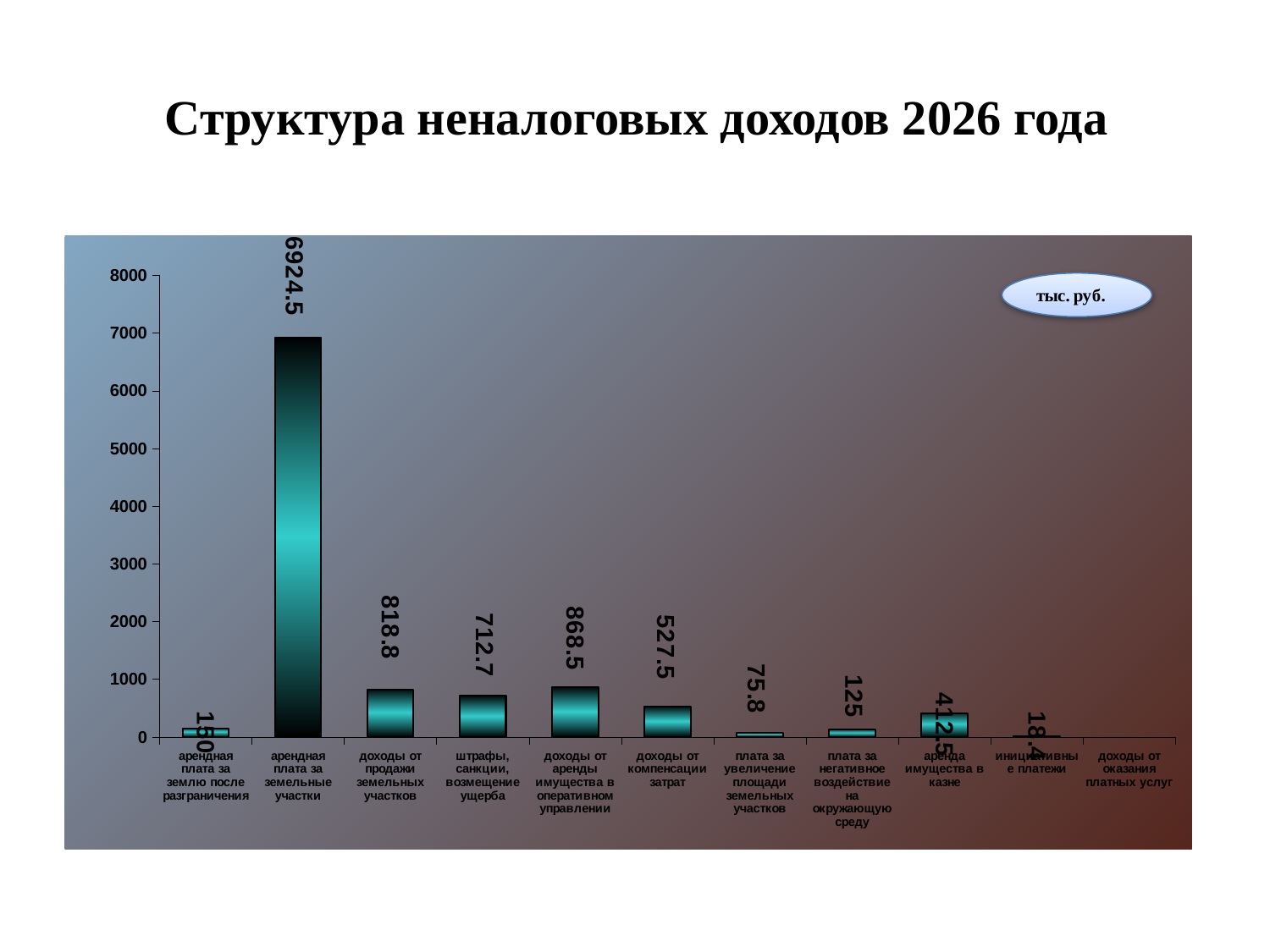
What kind of chart is shown on the slide? bar chart What is the value for 'аренда имущества в казне'? 412.5 What is the value for 'арендная плата за земельные участки'? 6924.5 What is the difference between 'арендная плата за землю после разграничения' and 'плата за негативное воздействие на окружающую среду'? 25 What unit of measurement is indicated on the chart? тыс. руб. Which is larger: 'доходы от компенсации затрат' or 'аренда имущества в казне'? доходы от компенсации затрат What is the value for 'доходы от продажи земельных участков'? 818.8 What is the value for 'штрафы, санкции, возмещение ущерба'? 712.7 Is the value for 'арендная плата за земельные участки' greater or less than 6000? greater Which category has the highest value? арендная плата за земельные участки What is the difference between 'доходы от аренды имущества в оперативном управлении' and 'доходы от продажи земельных участков'? 49.7 What is the value for 'плата за увеличение площади земельных участков'? 75.8